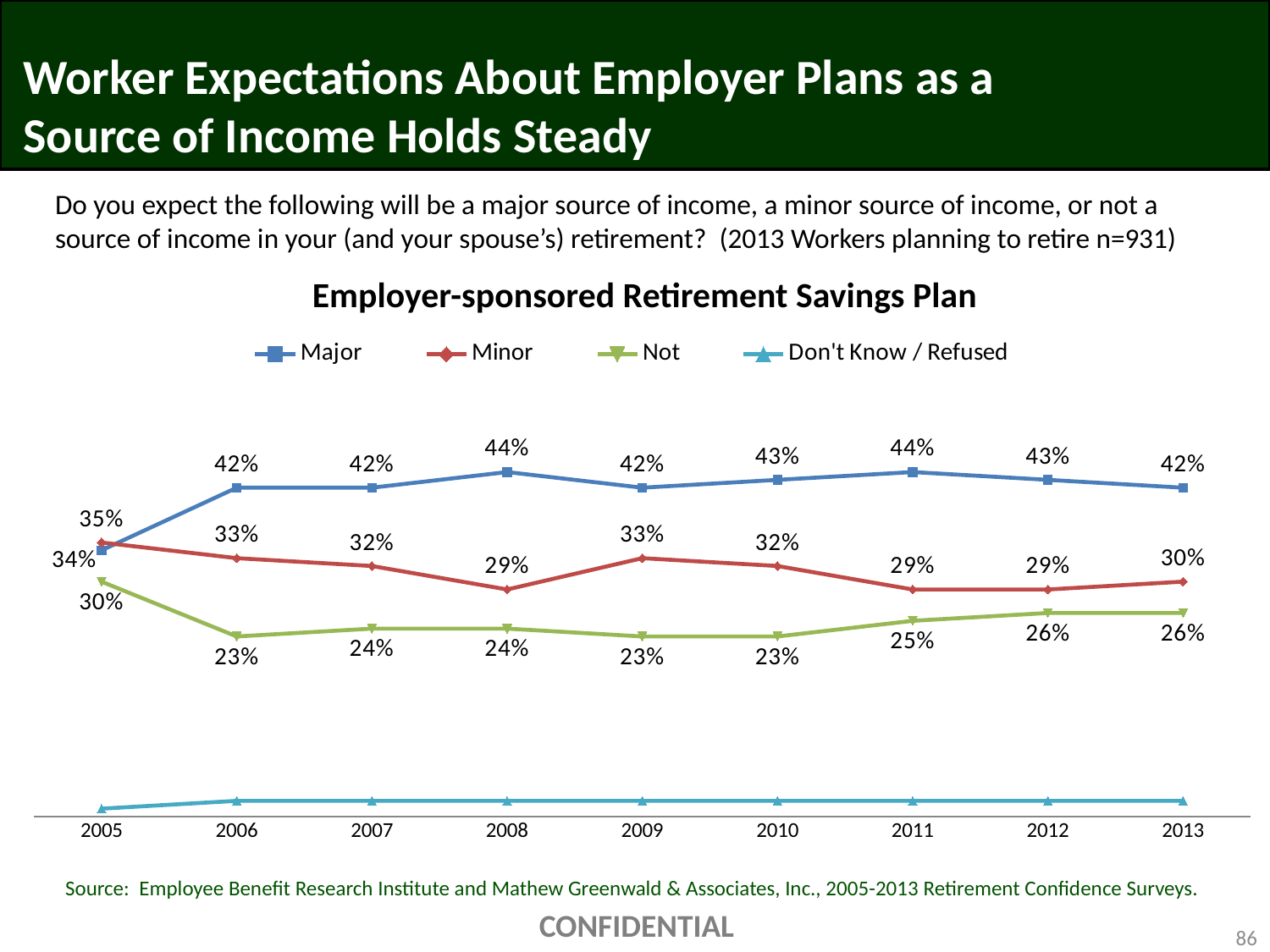
Which is larger in 2005, the Major value or the Minor value? Minor What is the title of the chart? Employer-sponsored Retirement Savings Plan How many series does the legend list? 4 In which year is the Major series at its lowest? 2005 How many years are plotted along the x axis? 9 What is the value for Not in 2012? 26% What is the value for Major in 2008? 44% In which year is the Not series at its highest? 2005 What kind of chart is shown on the slide? Line chart Does the Major series rise or fall from 2005 to 2006? Rise What is the difference between the Major and Minor values in 2013? 12 percentage points What is the value for Minor in 2009? 33%